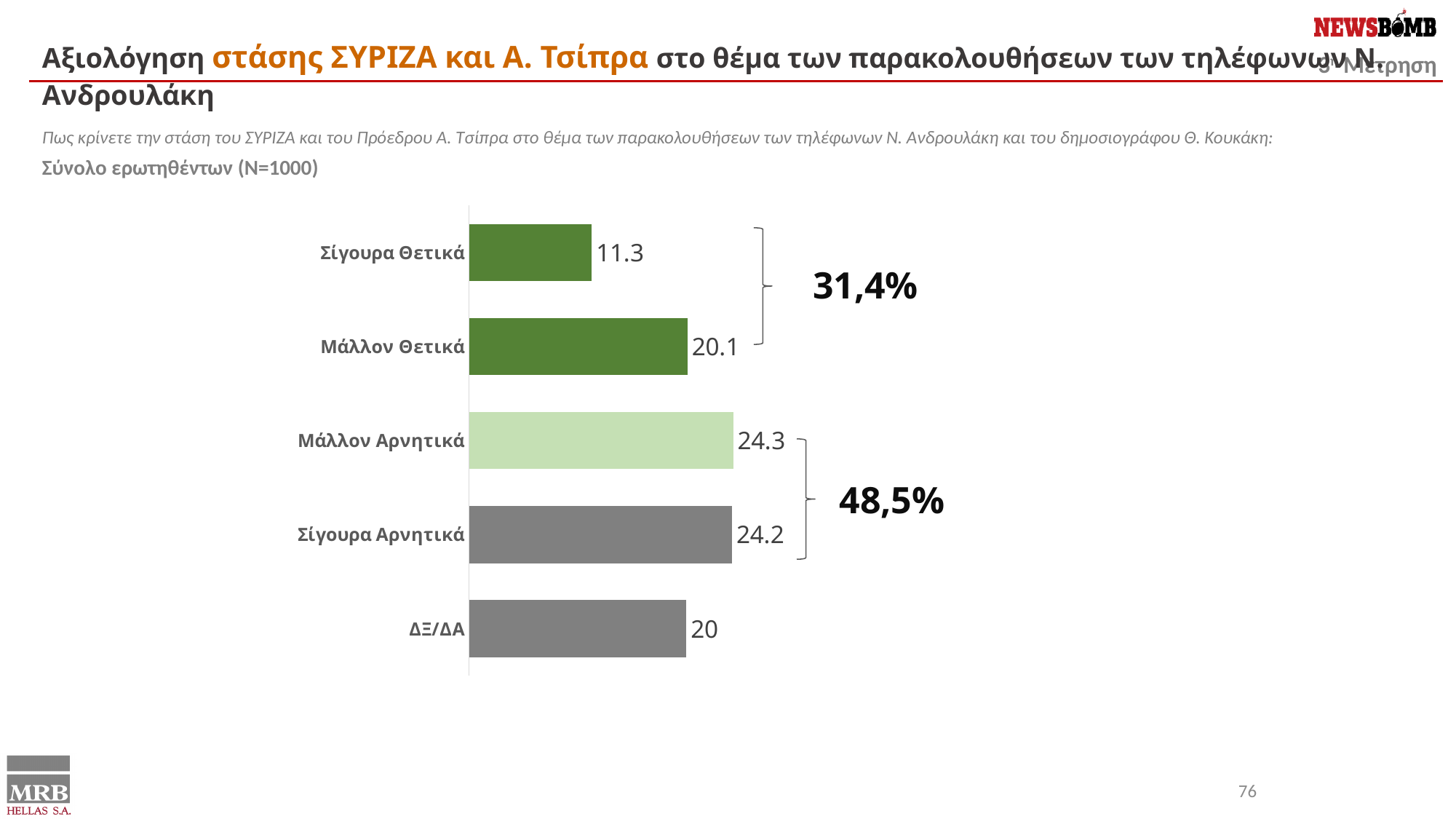
What is the difference between the values for Σίγουρα Αρνητικά and ΔΞ/ΔΑ? 4.2 Which category has the lowest value? Σίγουρα Θετικά What is the value for Μάλλον Θετικά? 20.1 What combined percentage is shown next to the bracket grouping Σίγουρα Θετικά and Μάλλον Θετικά? 31,4% What is the value for ΔΞ/ΔΑ? 20 What kind of chart is shown on the slide? bar chart Which is larger, the value for Σίγουρα Θετικά or the value for Μάλλον Θετικά? Μάλλον Θετικά What is the value for Μάλλον Αρνητικά? 24.3 What is the value for Σίγουρα Θετικά? 11.3 What is the difference between the values for Μάλλον Αρνητικά and Σίγουρα Θετικά? 13 How many categories are shown in the chart? 5 What is the value for Σίγουρα Αρνητικά? 24.2